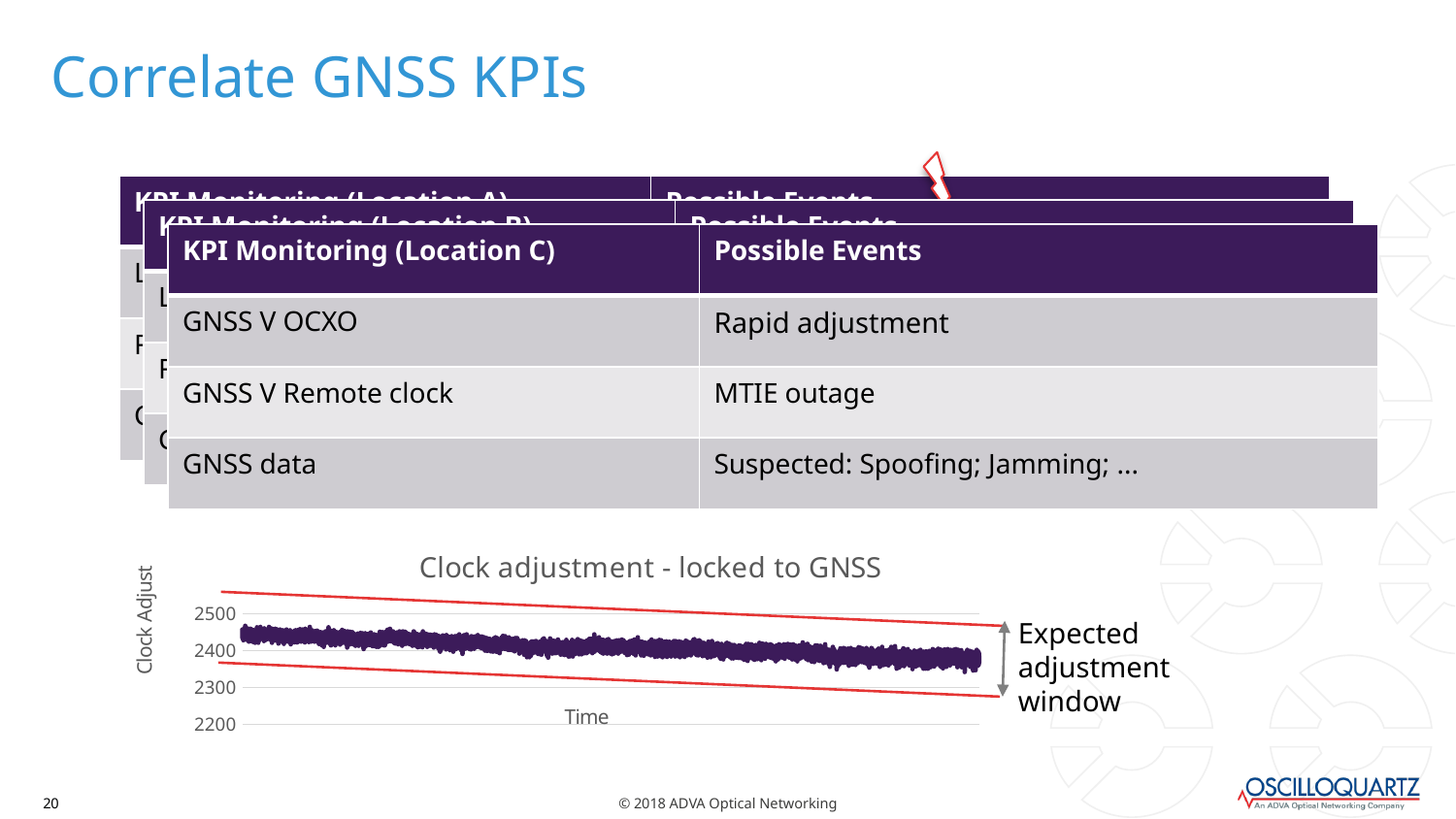
What kind of chart is shown at the bottom of the slide? line chart Do the plotted clock adjustment values rise or fall over time along the x axis? fall What is the highest tick value shown on the vertical axis of the chart? 2500 Is the plotted clock adjustment value at the end of the time axis greater or less than 2500? less How many tick values are labelled on the vertical axis of the chart? 4 Is the plotted clock adjustment value at the start of the time axis greater or less than 2400? greater What is the lowest tick value shown on the vertical axis of the chart? 2200 Is the plotted clock adjustment value at the start of the time axis greater or less than 2500? less What is the title of the chart on the slide? Clock adjustment - locked to GNSS What is the label of the vertical axis of the chart? Clock Adjust